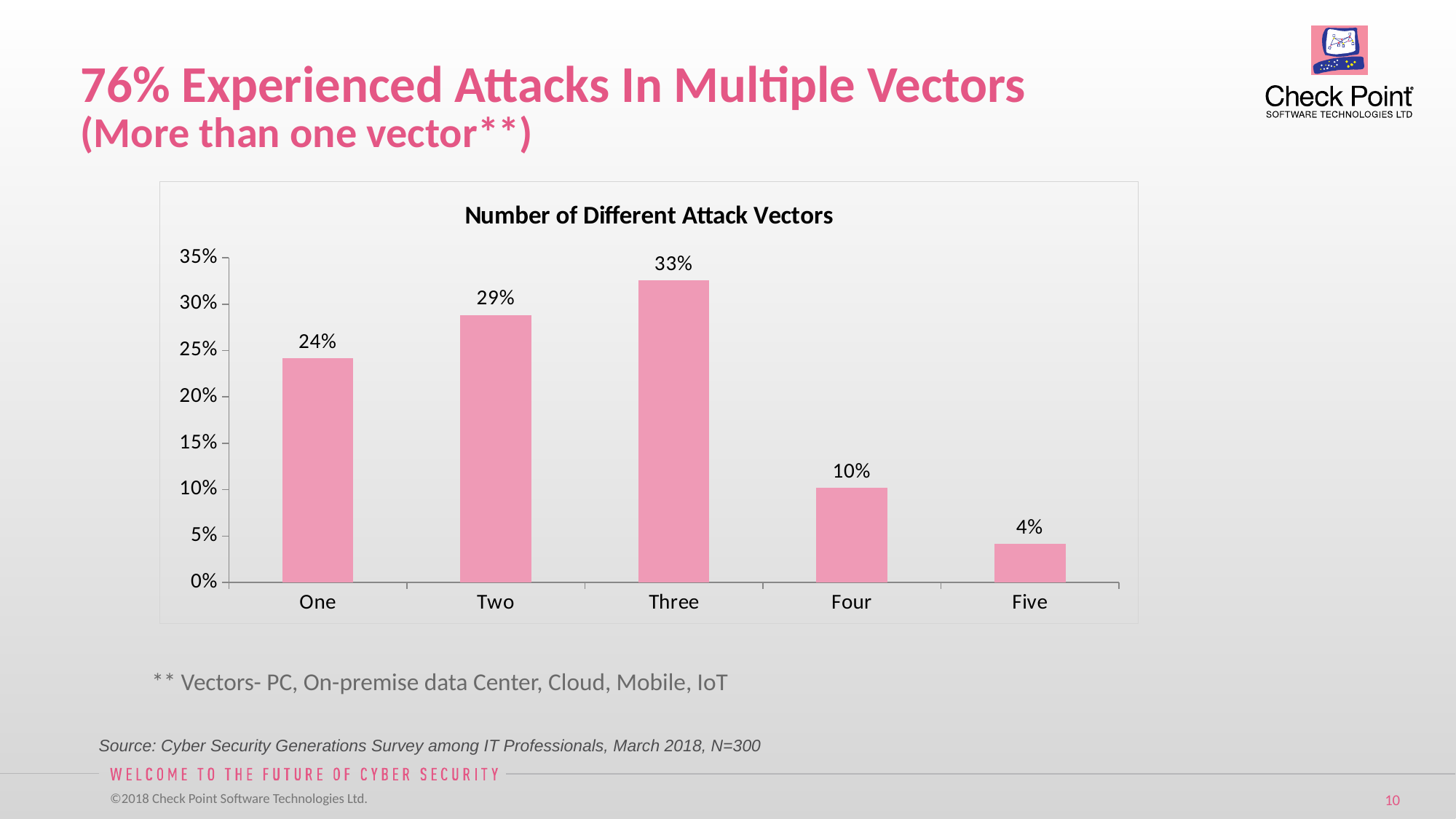
Which category has the lowest value in the Number of Different Attack Vectors chart? Five What is the value for One in the Number of Different Attack Vectors chart? 24% Which category has the highest value in the Number of Different Attack Vectors chart? Three What kind of chart is the Number of Different Attack Vectors chart? Bar chart What is the value for Three in the Number of Different Attack Vectors chart? 33% What is the title of the chart on the slide? Number of Different Attack Vectors Is the value for Two greater or less than 25% in the Number of Different Attack Vectors chart? greater How many categories are shown in the Number of Different Attack Vectors chart? 5 What is the value for Five in the Number of Different Attack Vectors chart? 4% What is the difference between the values for Four and Five in the Number of Different Attack Vectors chart? 6% Which is larger in the Number of Different Attack Vectors chart, the value for Two or the value for Four? Two What is the difference between the values for Three and Two in the Number of Different Attack Vectors chart? 4%